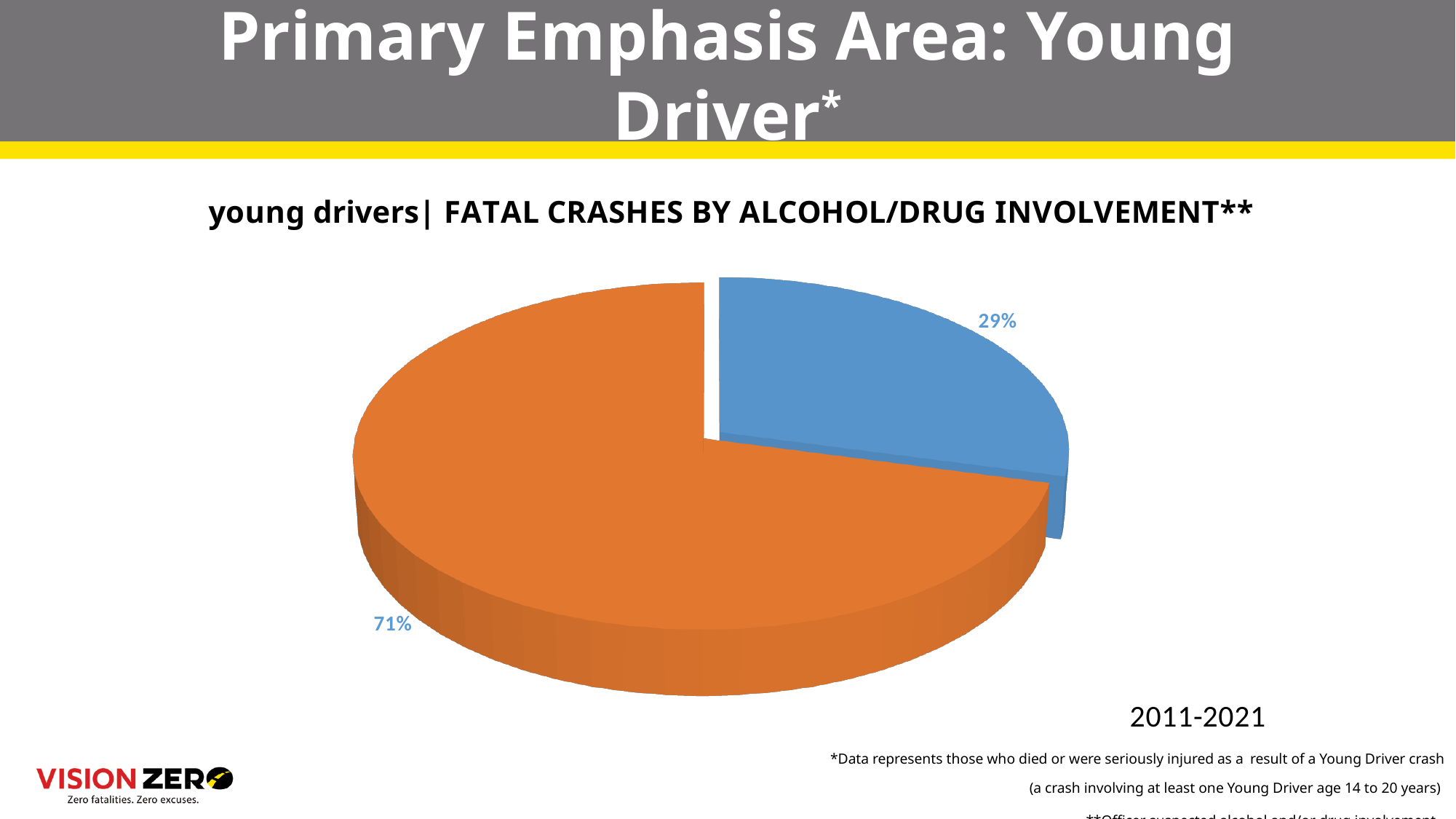
Which is larger, the blue slice or the orange slice? The orange slice What share of the pie does the orange slice represent? 71% How many slices does the pie chart have? 2 What is the title of the chart? young drivers| FATAL CRASHES BY ALCOHOL/DRUG INVOLVEMENT** What kind of chart is shown on the slide? Pie chart Which slice of the pie is the smallest? The blue slice (29%) What is the difference in percentage points between the orange slice and the blue slice? 42 percentage points What time period does the chart cover, according to the label below it? 2011-2021 Which slice of the pie is the largest? The orange slice (71%) What share of the pie does the blue slice represent? 29% Do the two slice percentages add up to 100%? Yes